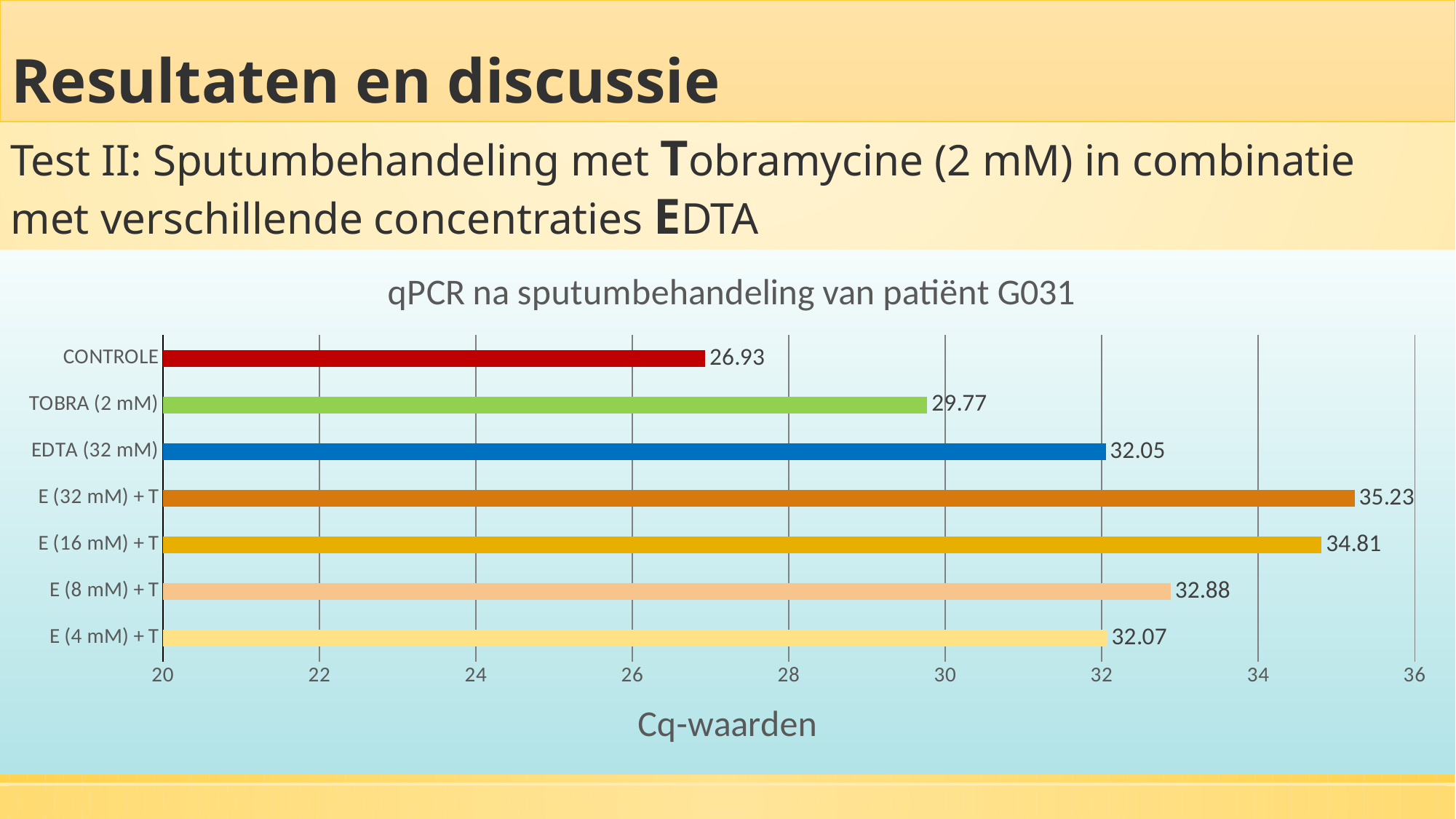
Which category has the highest Cq value? E (32 mM) + T What is the difference between the Cq values of TOBRA (2 mM) and CONTROLE? 2.84 What is the Cq value for CONTROLE? 26.93 How many categories are shown in the chart? 7 What is the Cq value for EDTA (32 mM)? 32.05 Which category has the lowest Cq value? CONTROLE What is the title of the chart? qPCR na sputumbehandeling van patiënt G031 What kind of chart is shown on the slide? bar chart Is the Cq value for TOBRA (2 mM) greater or less than 30? less What is the Cq value for E (16 mM) + T? 34.81 What is the difference between the Cq values of E (32 mM) + T and CONTROLE? 8.30 Which has a higher Cq value, E (8 mM) + T or E (4 mM) + T? E (8 mM) + T